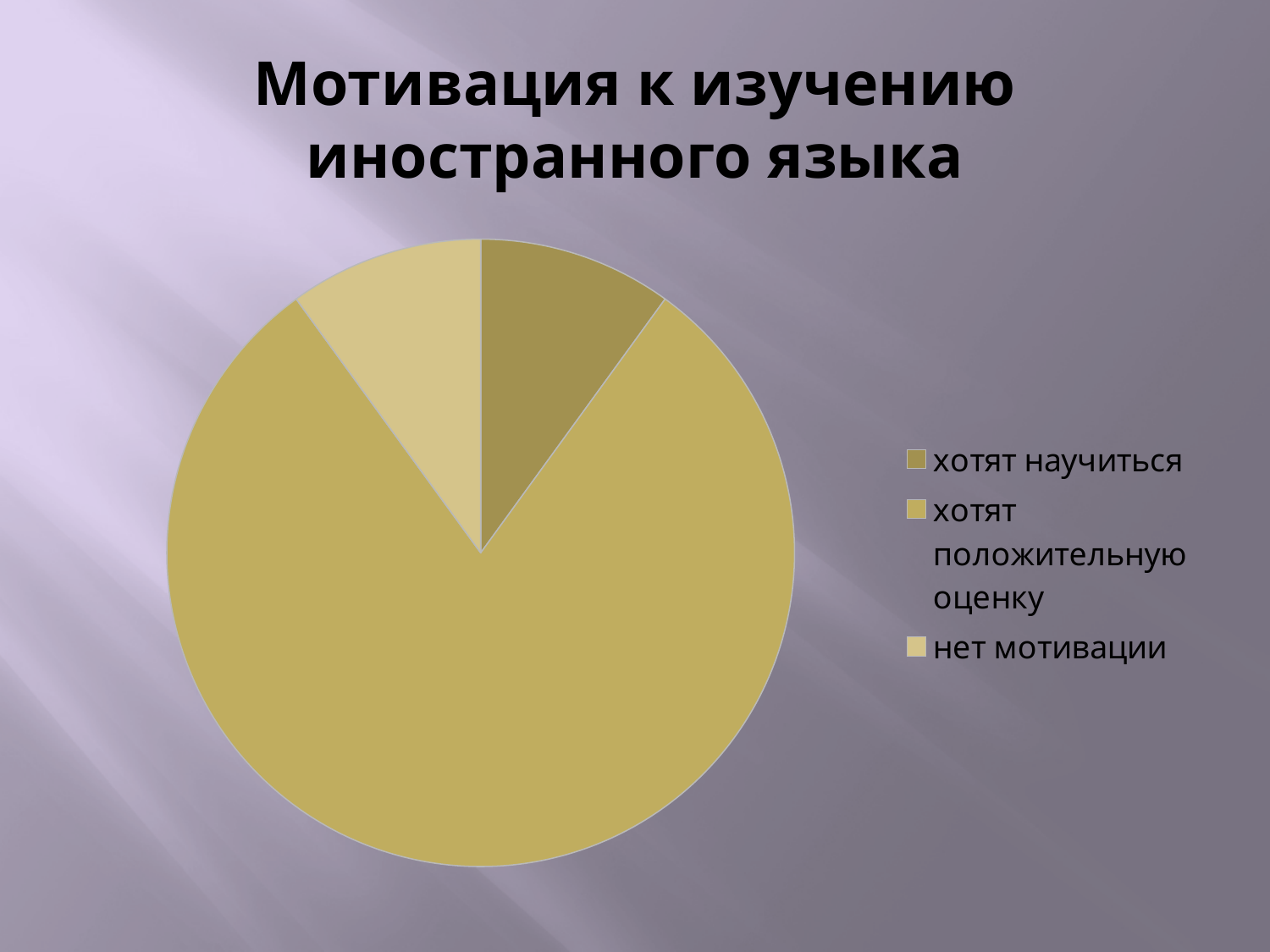
What kind of chart is shown on the slide? pie chart How many entries does the legend of the pie chart list? 3 What is the title of the slide with the pie chart? Мотивация к изучению иностранного языка Which legend entry is listed last in the pie chart's legend? нет мотивации Which category has the largest slice in the pie chart? хотят положительную оценку How many slices does the pie chart have? 3 Which slice is larger: "хотят положительную оценку" or "хотят научиться"? хотят положительную оценку Which slice is larger: "нет мотивации" or "хотят положительную оценку"? хотят положительную оценку